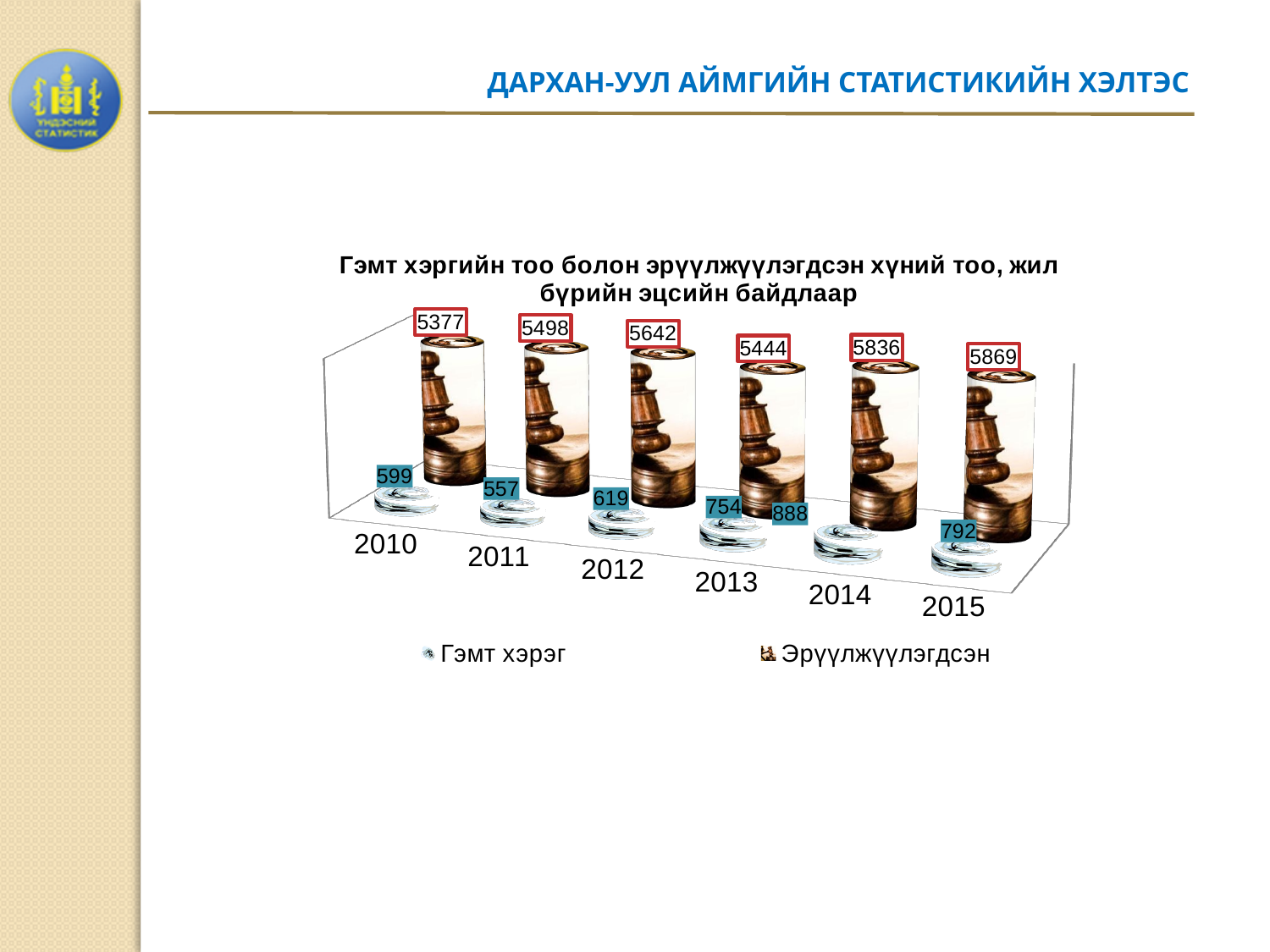
What kind of chart is shown on the slide? Bar chart What is the difference between the Эрүүлжүүлэгдсэн values for 2015 and 2010? 492 How many series does the legend list? 2 Which is larger, the Эрүүлжүүлэгдсэн value for 2012 or for 2013? 2012 What is the difference between the Гэмт хэрэг values for 2014 and 2013? 134 In which year is the Гэмт хэрэг value lowest? 2011 What is the value for Гэмт хэрэг in 2013? 754 In which year is the Гэмт хэрэг value highest? 2014 What is the value for Эрүүлжүүлэгдсэн in 2015? 5869 What is the value for Гэмт хэрэг in 2010? 599 In which year is the Эрүүлжүүлэгдсэн value lowest? 2010 How many years are shown on the x axis? 6